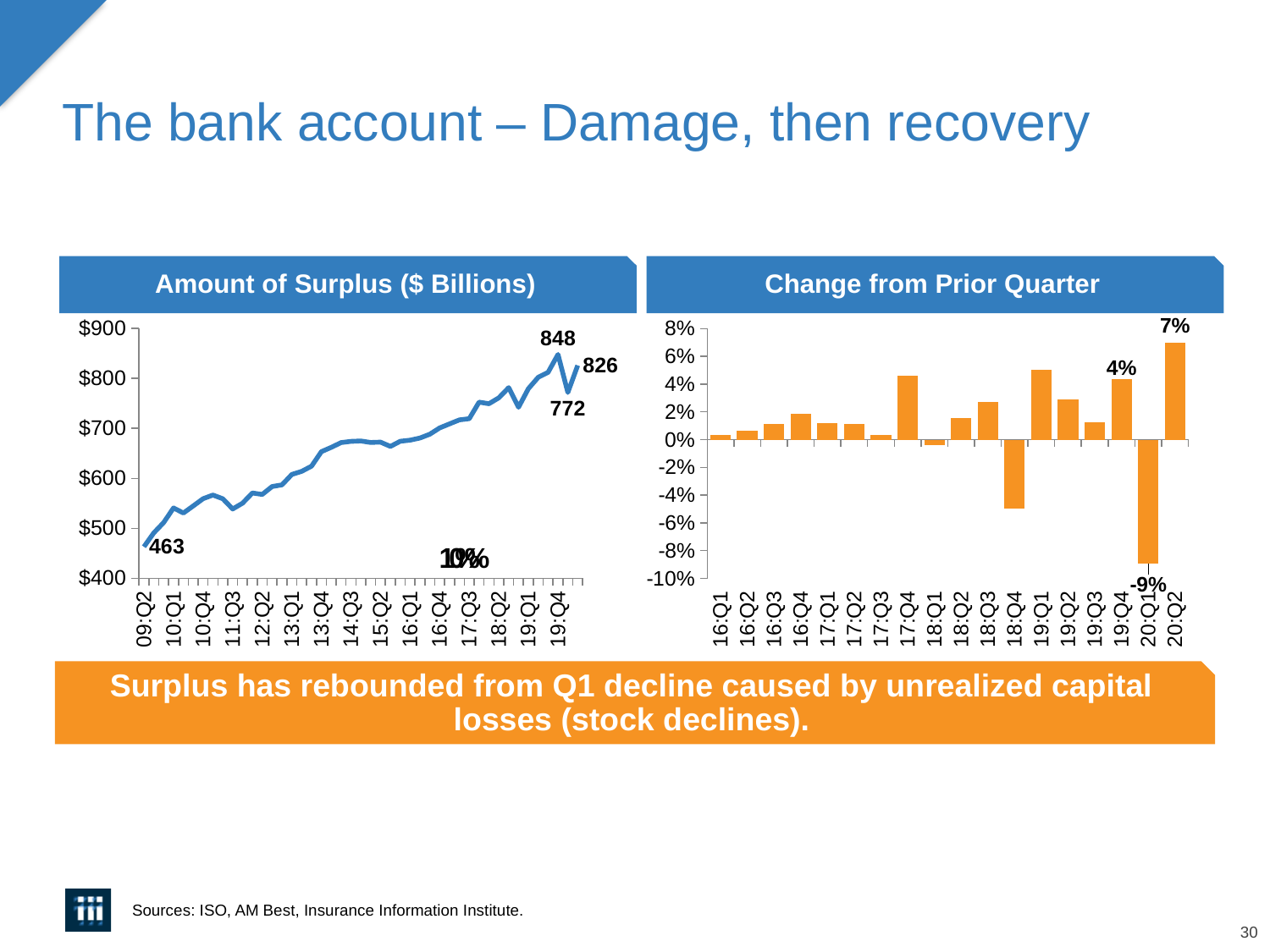
What kind of chart is the 'Change from Prior Quarter' chart on the right? bar chart In the 'Amount of Surplus ($ Billions)' chart, what is the difference between the labeled peak of 848 and the following labeled dip of 772? 76 What kind of chart is the 'Amount of Surplus ($ Billions)' chart on the left? line chart In the 'Change from Prior Quarter' chart, is the value for 18:Q4 greater or less than -4%? less In the 'Change from Prior Quarter' chart, which quarter has the highest value? 20:Q2 How many quarters are plotted in the 'Change from Prior Quarter' chart? 18 In the 'Amount of Surplus ($ Billions)' chart, what is the highest labeled value on the line? 848 In the 'Change from Prior Quarter' chart, which quarter has the lowest value? 20:Q1 In the 'Amount of Surplus ($ Billions)' chart, what is the labeled value at the start of the line (09:Q2)? 463 In the 'Change from Prior Quarter' chart, what is the value for 20:Q2? 7% In the 'Change from Prior Quarter' chart, what is the value for 20:Q1? -9% In the 'Change from Prior Quarter' chart, what is the value for 19:Q4? 4%